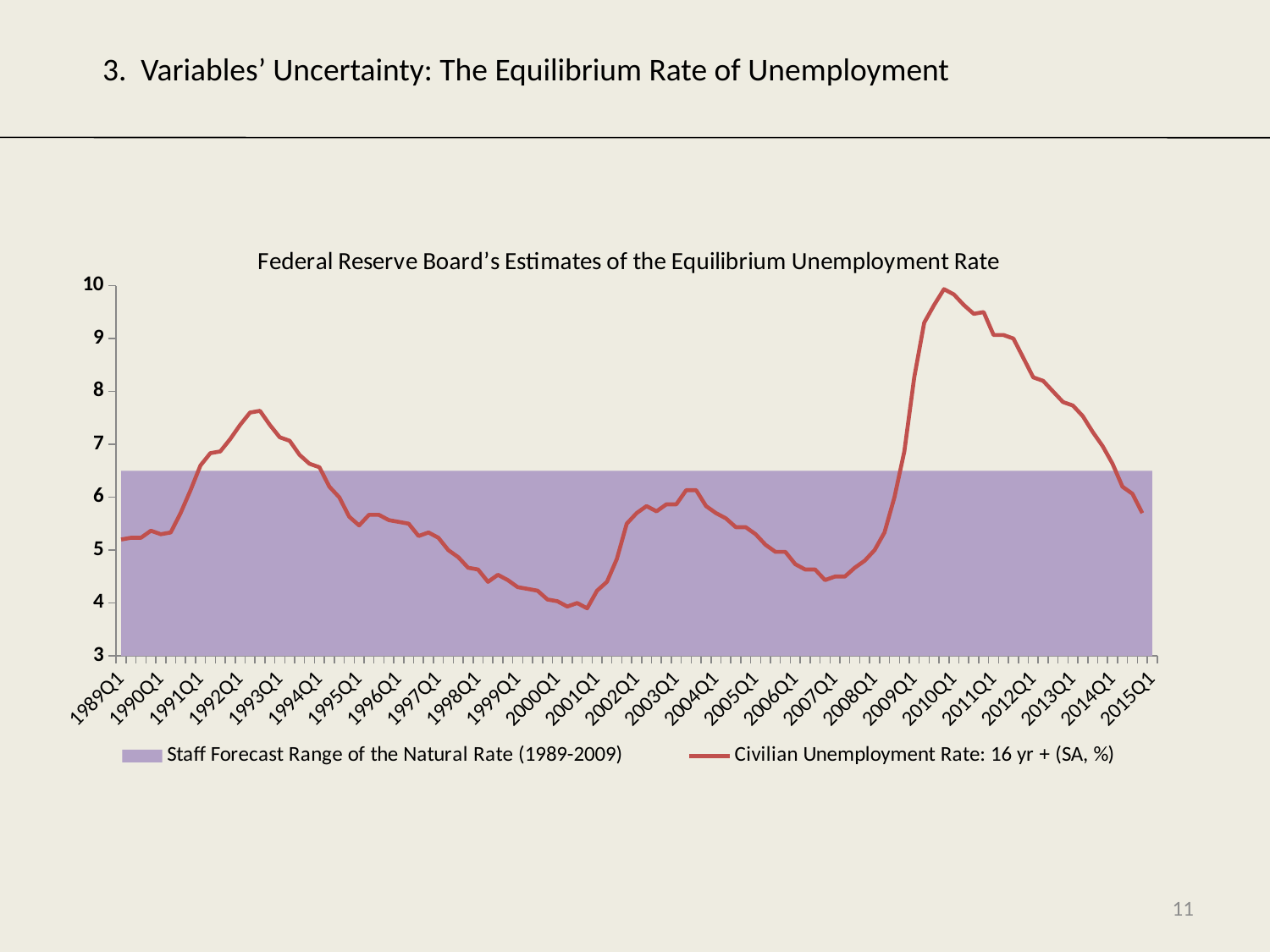
Is the Civilian Unemployment Rate at 1992Q1 greater or less than 7? greater Does the Civilian Unemployment Rate rise or fall between 2010Q1 and 2015Q1? Fall What does the shaded purple band represent according to the legend? Staff Forecast Range of the Natural Rate (1989-2009) Is the Civilian Unemployment Rate at 2007Q1 greater or less than 5? less How many quarter labels are shown on the x axis? 27 Around which labelled quarter does the Civilian Unemployment Rate reach its highest value? 2010Q1 Is the Civilian Unemployment Rate at 2010Q1 greater or less than 9? greater How many series does the legend list? 2 Which is larger, the Civilian Unemployment Rate at 1992Q1 or at 2003Q1? 1992Q1 What kind of chart is shown on the slide? Combination area and line chart (a line with a shaded area band) What is the title of the chart? Federal Reserve Board's Estimates of the Equilibrium Unemployment Rate